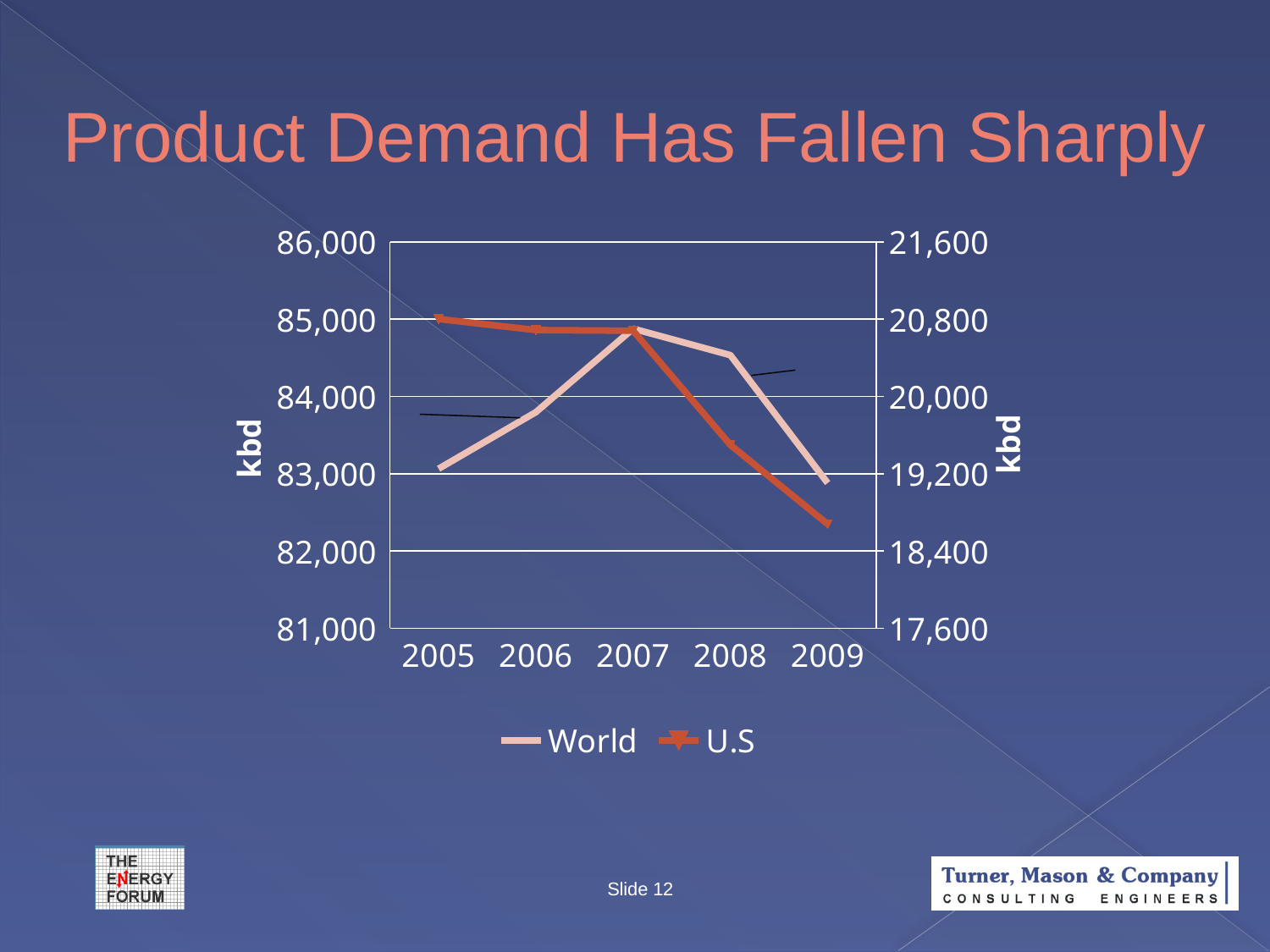
In which year does the World series reach its highest value? 2007 Is the U.S value for 2005 greater or less than 20,000? greater What kind of chart is shown on the slide? line chart What is the title of the slide containing the chart? Product Demand Has Fallen Sharply Is the World value for 2008 greater or less than 84,000? greater Is the U.S value for 2009 greater or less than 19,200? less How many years are plotted along the x axis? 5 In which year does the U.S series reach its lowest value? 2009 Which is larger for the World series, the value in 2005 or the value in 2007? 2007 How many series does the legend list? 2 Does the U.S series rise or fall from 2007 to 2009? fall